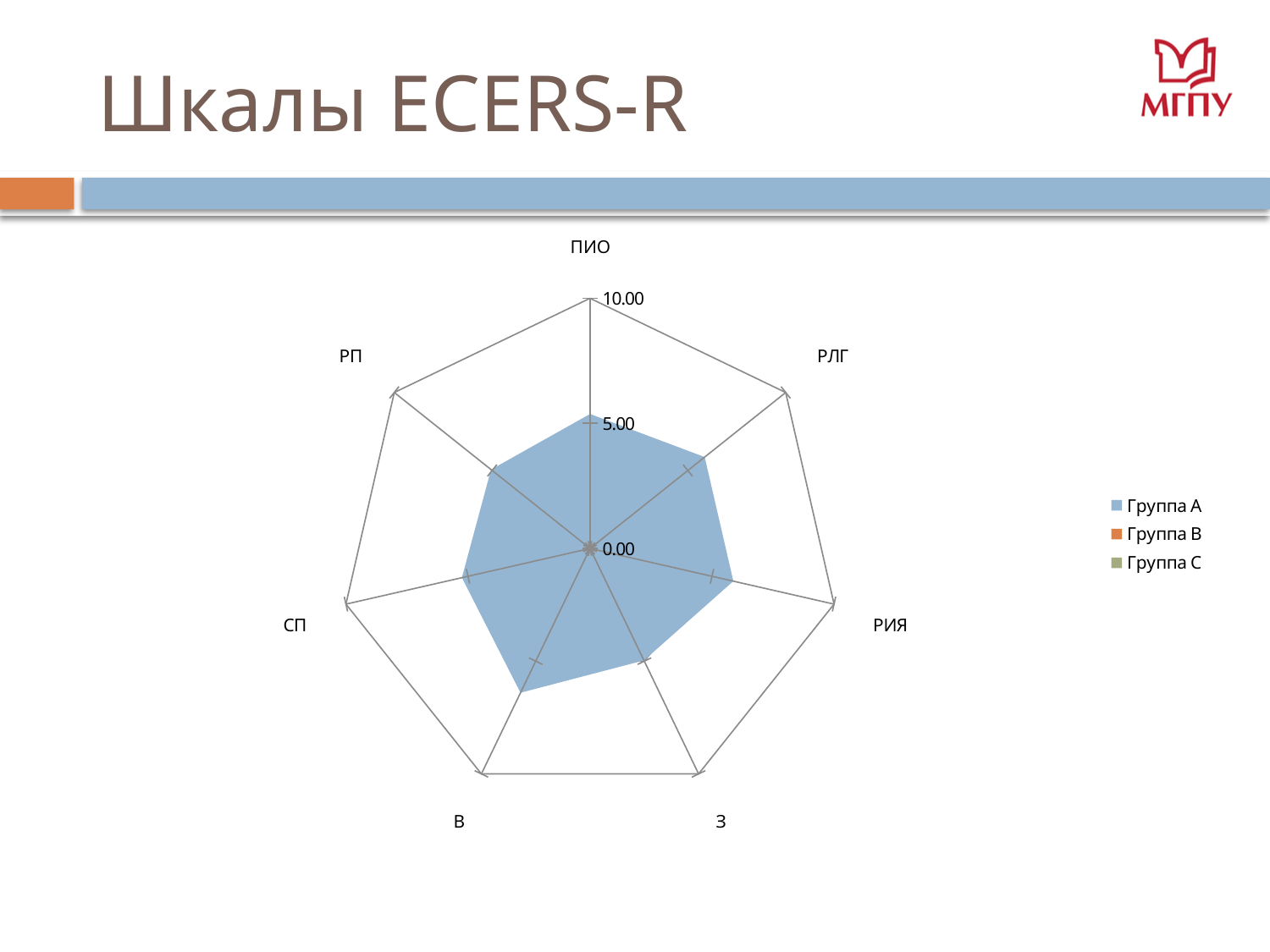
Is the value for РИЯ greater or less than 5.00? greater Is the value for З greater or less than 10.00? less Is the value for РЛГ greater or less than 5.00? greater How many categories (axes) does the radar chart have? 7 What kind of chart is shown on the slide? radar chart What is the title of the slide containing the chart? Шкалы ECERS-R How many series does the legend list? 3 What is the maximum value shown on the radar chart's axis? 10.00 Which series names are listed in the legend? Группа A, Группа B, Группа C